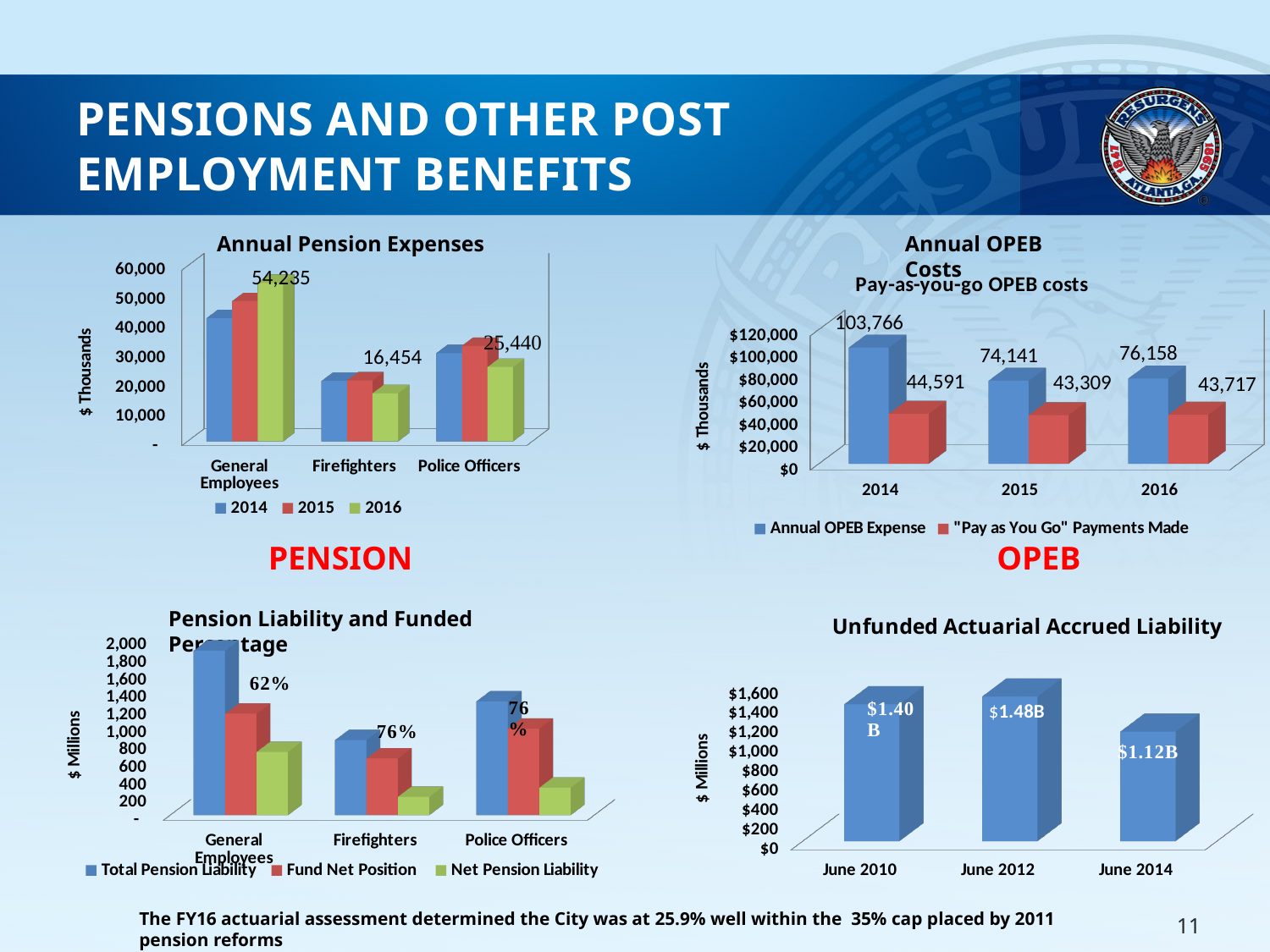
In the Annual Pension Expenses chart, which is larger for 2016: Firefighters or Police Officers? Police Officers In the Annual OPEB Costs chart, what were the "Pay as You Go" Payments Made in 2015? 43,309 In the Unfunded Actuarial Accrued Liability chart, what is the value for June 2012? $1.48B In the Annual Pension Expenses chart, what is the 2016 value for General Employees? 54,235 In the Annual OPEB Costs chart, what is the difference between the Annual OPEB Expense and the "Pay as You Go" Payments Made in 2016? 32,441 In the Pension Liability and Funded Percentage chart, what funded percentage is shown for General Employees? 62% How many series does the legend of the Annual OPEB Costs chart list? 2 In the Annual OPEB Costs chart, which year has the highest Annual OPEB Expense? 2014 In the Unfunded Actuarial Accrued Liability chart, which date has the lowest value? June 2014 In the Unfunded Actuarial Accrued Liability chart, by how much did the value fall from June 2012 to June 2014? $0.36B In the Annual Pension Expenses chart, is the 2014 value for General Employees greater or less than 30,000? greater In the Annual OPEB Costs chart, what is the Annual OPEB Expense for 2014? 103,766